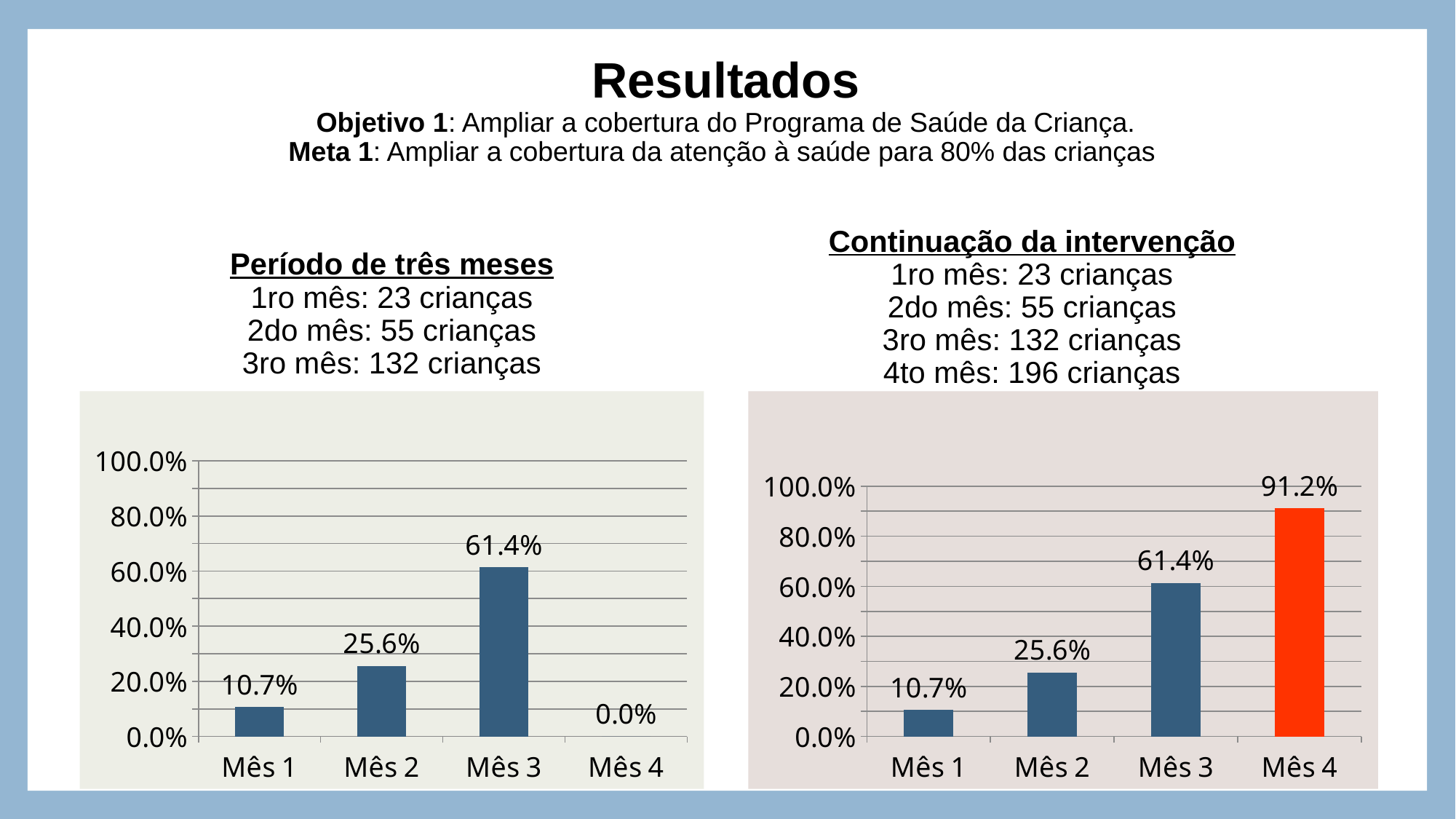
In the right chart, which month has the highest value? Mês 4 How many categories are shown on the x axis of the right chart? 4 What kind of chart is the left chart? Bar chart In the right chart, what is the difference between the values for Mês 4 and Mês 3? 29.8% In the left chart, what is the value for Mês 3? 61.4% In the right chart, is the value for Mês 4 greater or less than 80%? greater In the left chart, what is the value for Mês 4? 0.0% In the right chart, which is larger, the value for Mês 2 or the value for Mês 3? Mês 3 In the left chart, which month has the lowest value? Mês 4 In the left chart, what is the difference between the values for Mês 3 and Mês 2? 35.8% In the right chart, what is the value for Mês 1? 10.7% In the right chart, what is the value for Mês 4? 91.2%